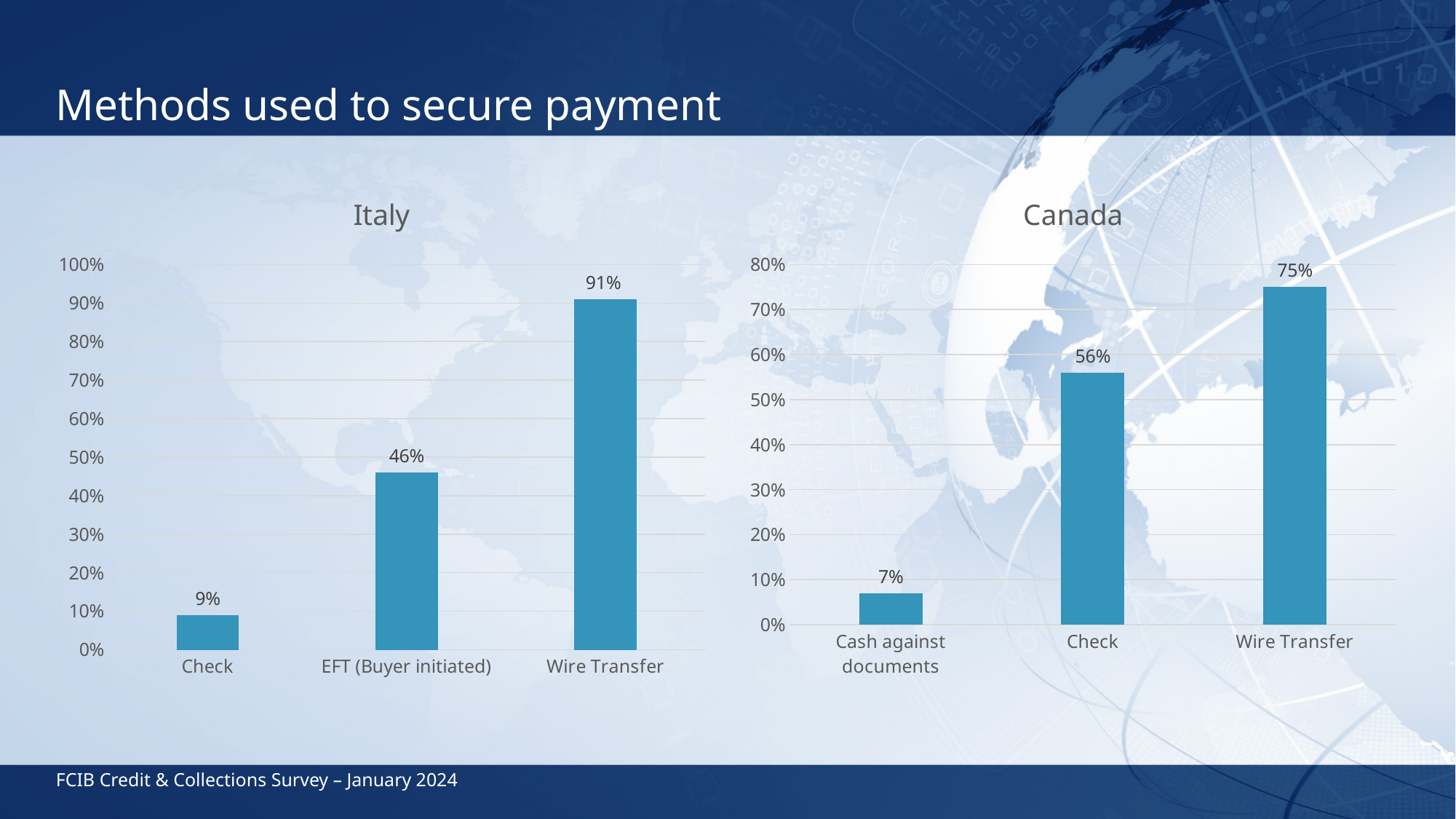
In the Canada chart, what is the value for Check? 56% In the Italy chart, do the values rise or fall from left to right? Rise In the Canada chart, what is the difference between Wire Transfer and Check? 19% What type of chart is the Italy chart? Bar chart In the Italy chart, what is the value for EFT (Buyer initiated)? 46% In the Italy chart, what is the value for Wire Transfer? 91% In the Canada chart, what is the value for Cash against documents? 7% In the Italy chart, what is the difference between Wire Transfer and Check? 82% In the Canada chart, which category has the highest value? Wire Transfer In the Canada chart, how many categories are shown? 3 Which is larger: the Check value in the Italy chart or the Check value in the Canada chart? Canada In the Italy chart, which category has the lowest value? Check